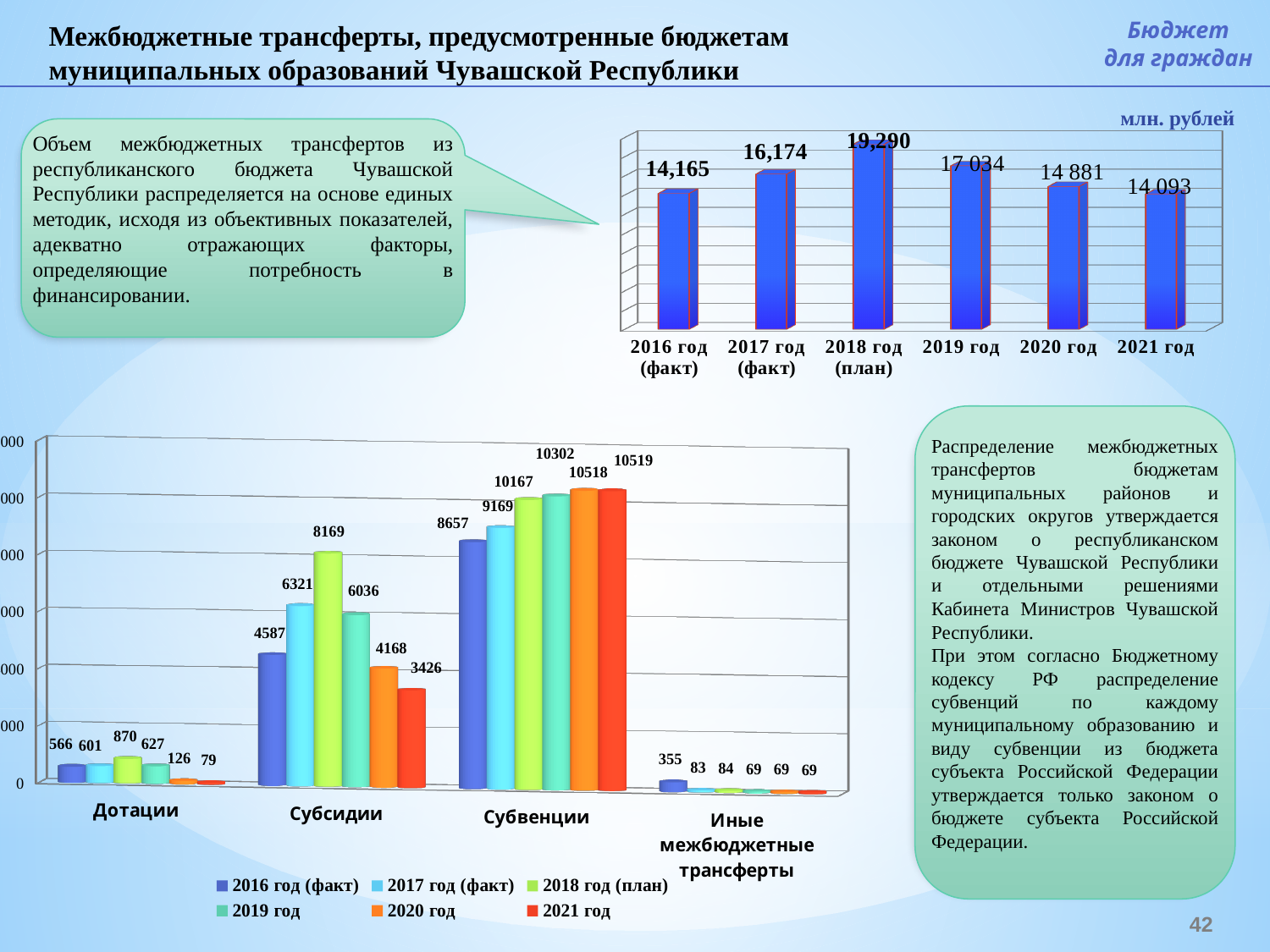
In the bottom chart, how many series does the legend list? 6 In the bottom chart, what is the value for Субсидии in 2018 год (план)? 8169 In the top-right chart, what is the difference between the values for 2017 год (факт) and 2016 год (факт)? 2,009 In the bottom chart, what is the difference between the Субсидии values for 2017 год (факт) and 2021 год? 2895 What type of chart is the bottom chart? Bar chart In the top-right chart, what is the value for 2018 год (план)? 19,290 In the bottom chart, what is the value for Дотации in 2021 год? 79 In the top-right chart, which year has the lowest value? 2021 год In the top-right chart, what unit is stated above the chart? млн. рублей In the bottom chart, which is larger for Субвенции: 2016 год (факт) or 2020 год? 2020 год In the top-right chart, how many years are shown on the x axis? 6 In the top-right chart, which year has the highest value? 2018 год (план)